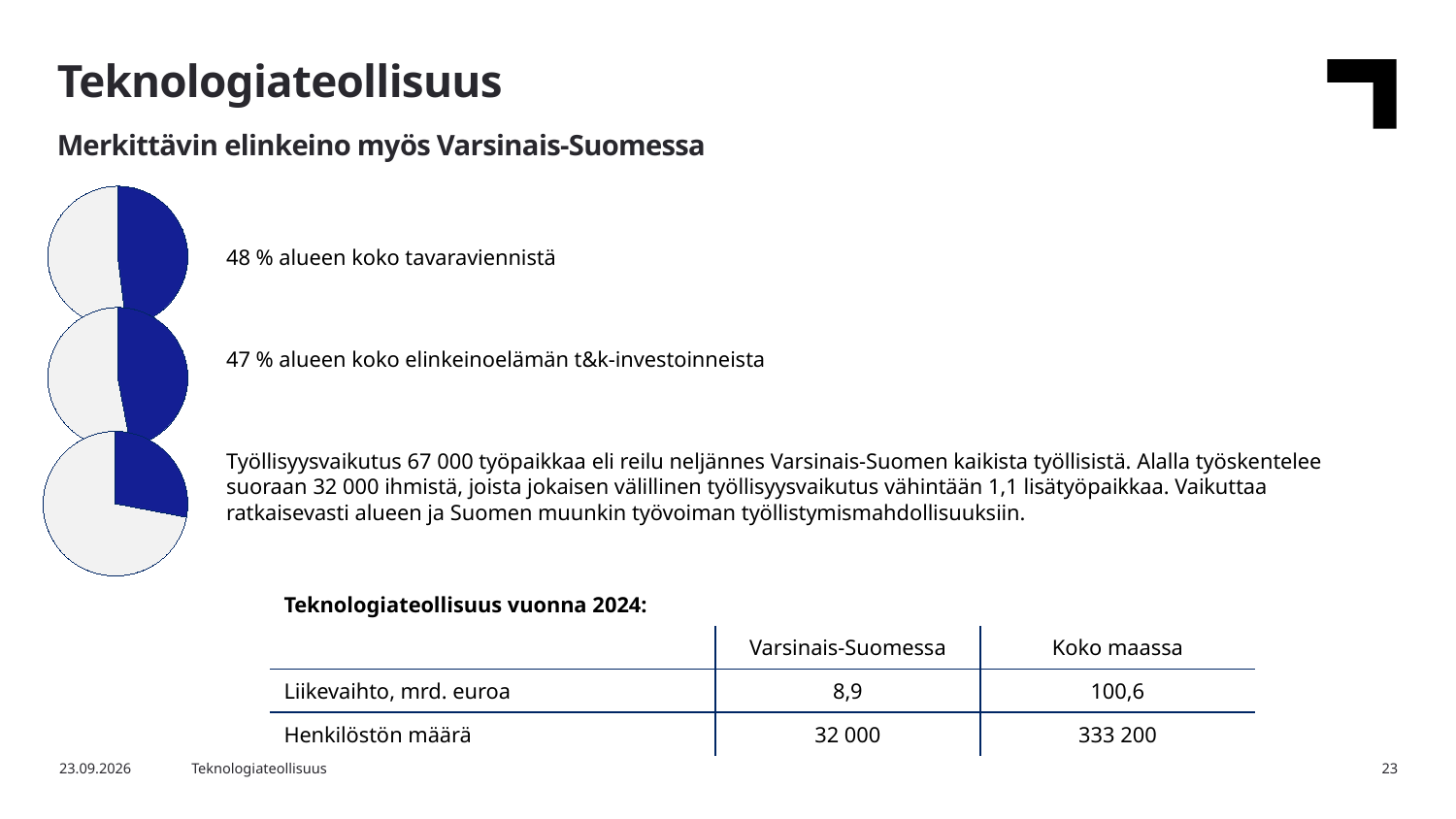
What colour is the highlighted slice in each pie chart? Blue What share does the highlighted (blue) slice of the top pie chart represent, according to the text next to it? 48 % Which has a larger highlighted slice, the top pie chart or the bottom pie chart? The top pie chart What does the top pie chart's highlighted slice represent, according to the text beside it? 48 % alueen koko tavaraviennistä Which of the three pie charts has the smallest highlighted slice? The bottom pie chart What kind of charts are shown on the left side of the slide? Pie charts Is the highlighted slice of the bottom pie chart greater or less than 50%? less How many pie charts are on the slide? 3 What share does the highlighted (blue) slice of the middle pie chart represent, according to the text next to it? 47 %